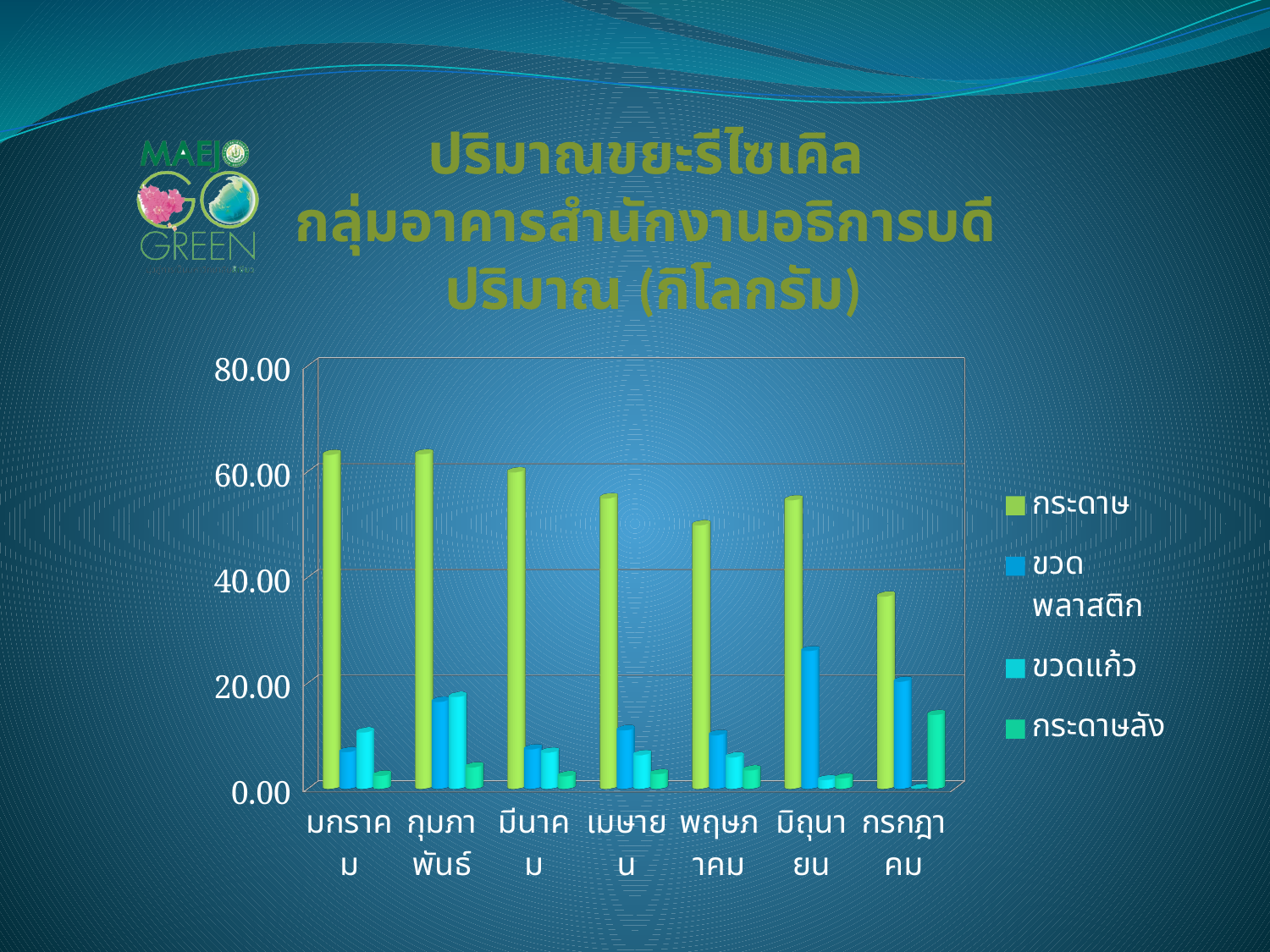
Does the value for กระดาษ generally rise or fall from มกราคม to กรกฎาคม? fall Which is larger: กระดาษ in มกราคม or กระดาษ in กรกฎาคม? กระดาษ in มกราคม How many series does the legend list? 4 In which month is the value for ขวดแก้ว the highest? กุมภาพันธ์ Which colour represents กระดาษ in the legend? green What kind of chart is shown on the slide? bar chart How many months (categories) are shown on the x axis? 7 In which month is the value for ขวดพลาสติก the highest? มิถุนายน In which month is the value for กระดาษ the lowest? กรกฎาคม Is the value for ขวดพลาสติก in มิถุนายน greater or less than 20.00? greater In which month is the value for กระดาษลัง the highest? กรกฎาคม Is the value for กระดาษ in กรกฎาคม greater or less than 40.00? less